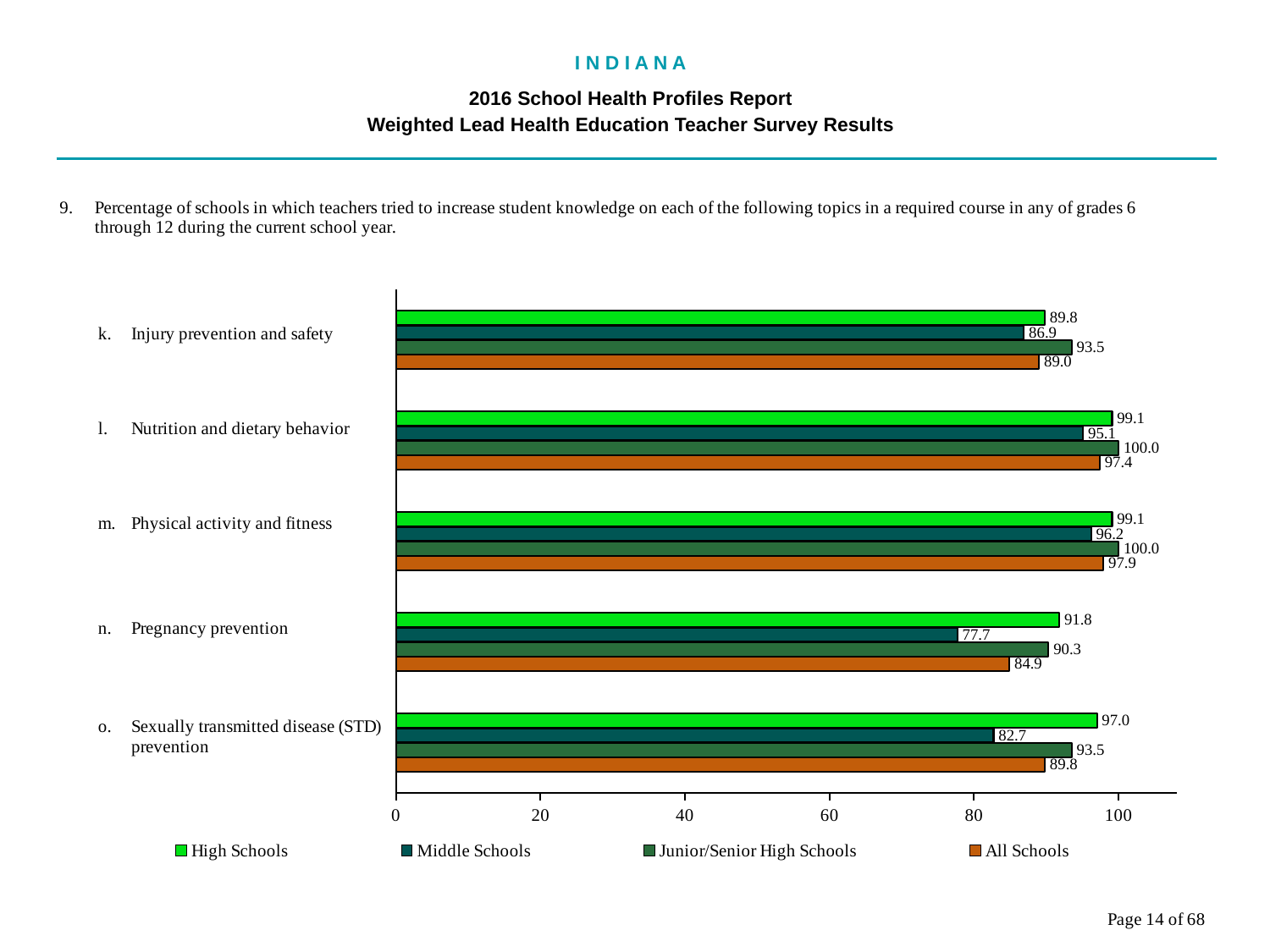
What is the value for High Schools for Injury prevention and safety? 89.8 What is the value for All Schools for Sexually transmitted disease (STD) prevention? 89.8 What is the value for Junior/Senior High Schools for Nutrition and dietary behavior? 100.0 Which is larger for Pregnancy prevention: the High Schools value or the Junior/Senior High Schools value? High Schools What kind of chart is shown on the slide? Bar chart Which topic has the highest value for All Schools? Physical activity and fitness How many topics are shown on the chart? 5 What is the difference between the High Schools and Middle Schools values for Sexually transmitted disease (STD) prevention? 14.3 What is the value for Middle Schools for Pregnancy prevention? 77.7 How many series does the legend list? 4 Which topic has the lowest value for Middle Schools? Pregnancy prevention Which series is shown in orange in the legend? All Schools